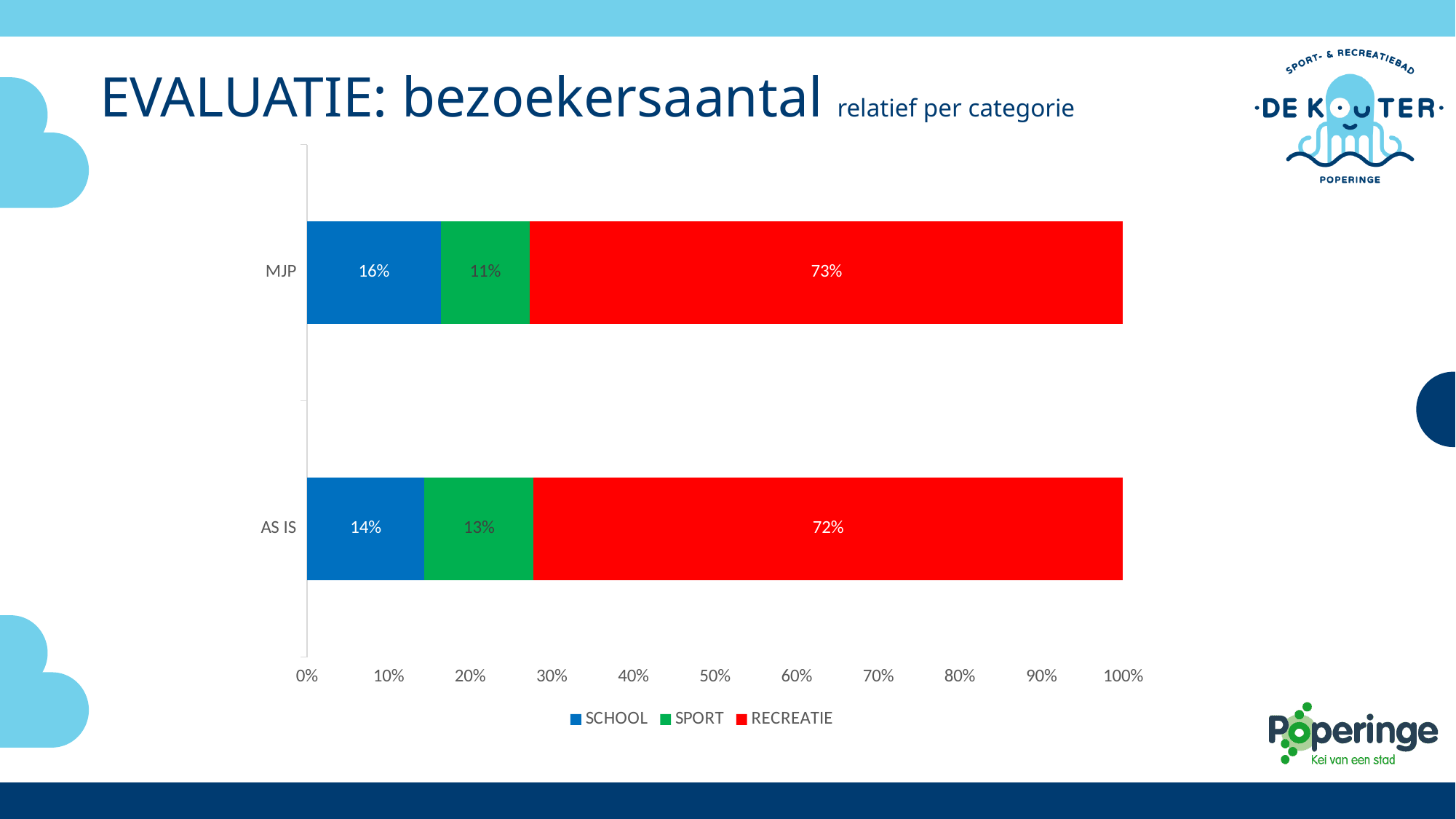
How many series does the legend list? 3 Which series has the smallest share in the MJP bar? SPORT What colour represents RECREATIE in the chart? Red How many categories are shown on the vertical axis? 2 Which series has the largest share in the AS IS bar? RECREATIE What is the SCHOOL value for AS IS? 14% What is the difference between the SCHOOL values for MJP and AS IS? 2% What is the RECREATIE value for MJP? 73% What is the SCHOOL value for MJP? 16% What is the SPORT value for AS IS? 13% Is the SPORT value larger for MJP or for AS IS? AS IS What kind of chart is shown on the slide? Stacked bar chart